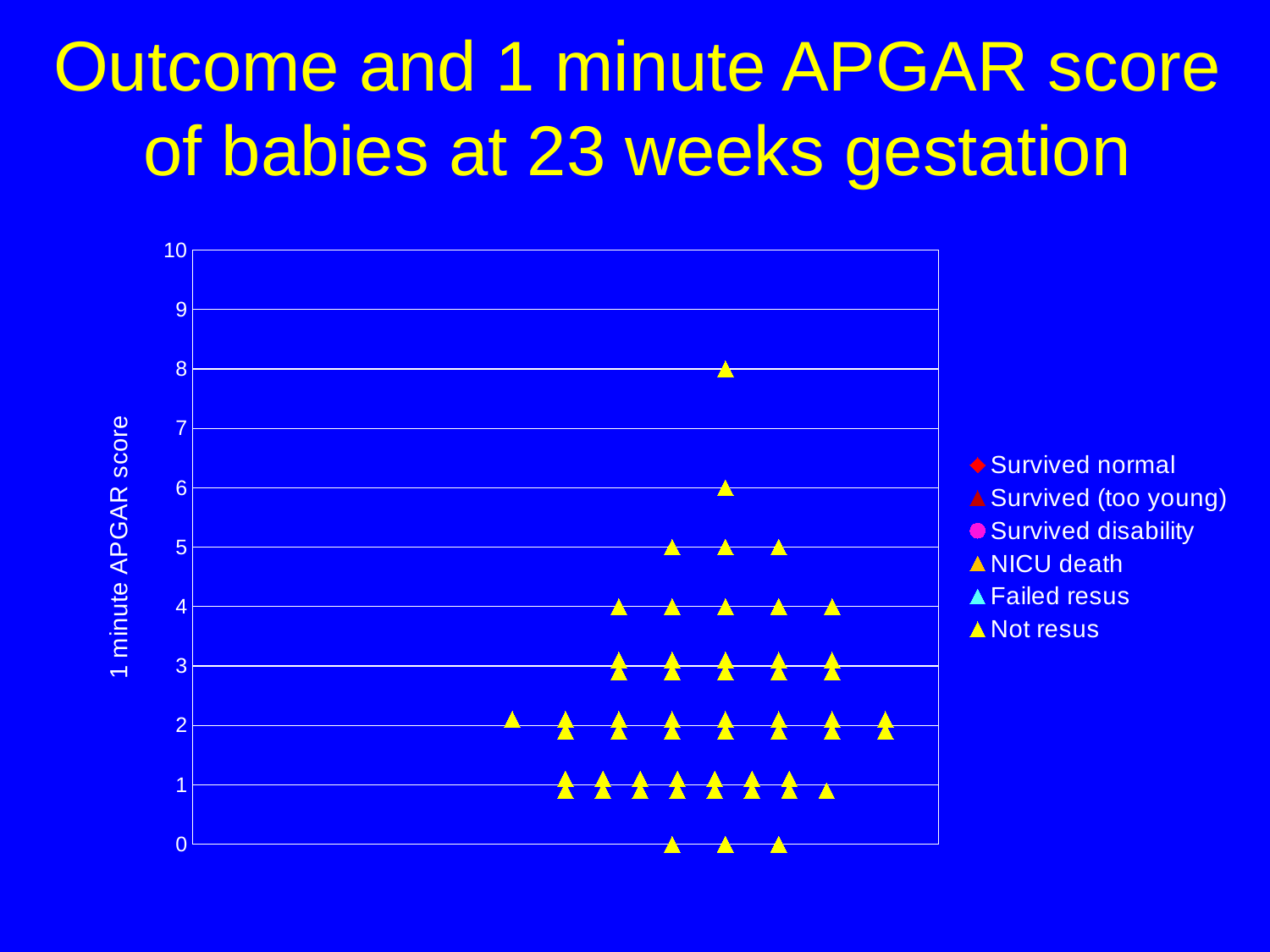
How many points are plotted at an APGAR score of 5? 3 How many points are plotted at an APGAR score of 8? 1 Is the highest plotted APGAR score greater or less than 5? greater What is the title of the slide's chart? Outcome and 1 minute APGAR score of babies at 23 weeks gestation What is the label on the vertical axis? 1 minute APGAR score What kind of chart is shown on the slide? scatter chart How many series does the legend list? 6 What is the lowest 1 minute APGAR score at which a point is plotted? 0 What is the maximum value shown on the vertical axis? 10 How many points are plotted at an APGAR score of 6? 1 What is the highest 1 minute APGAR score at which a point is plotted? 8